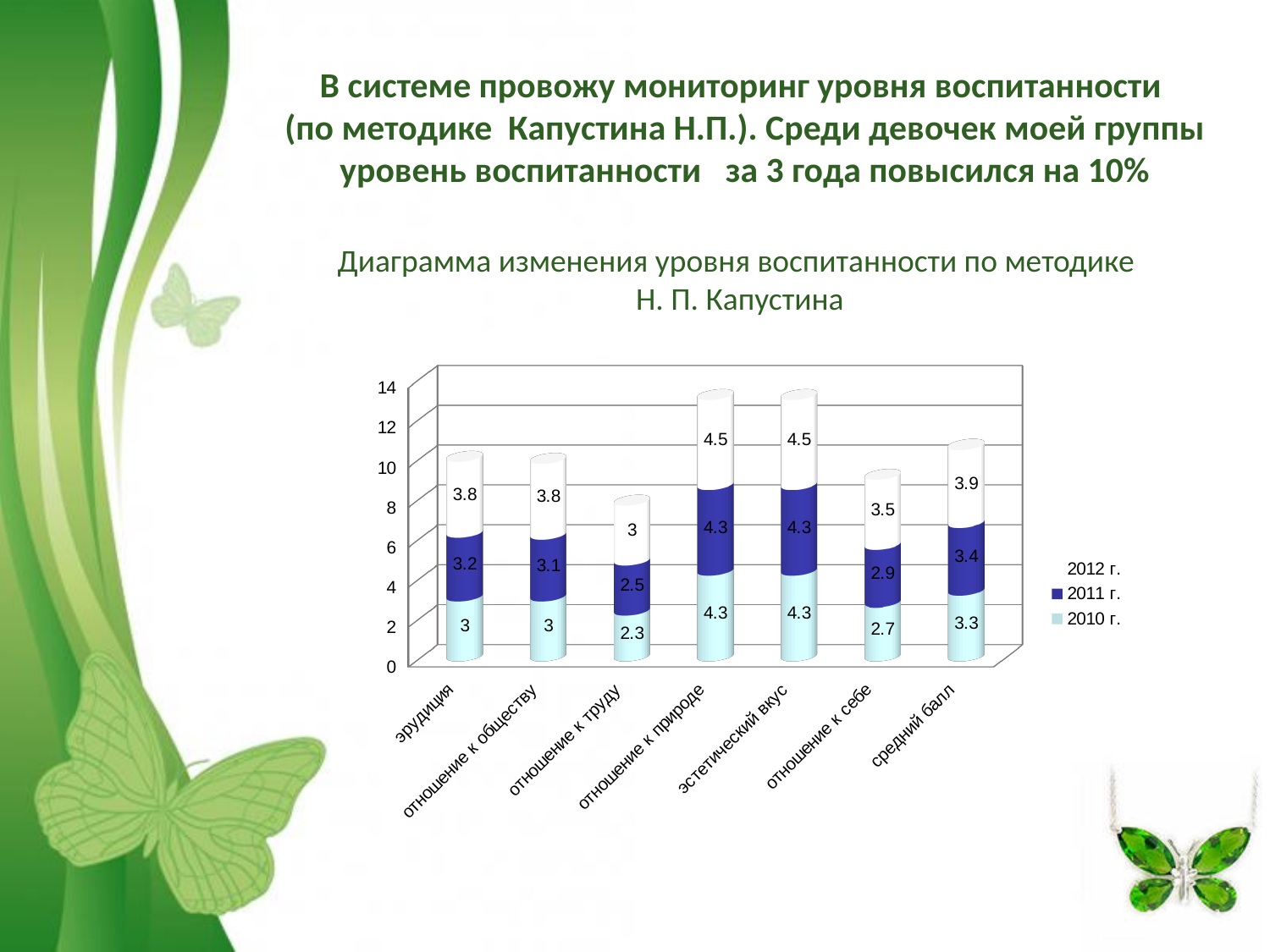
Which category has the lowest 2012 г. value? отношение к труду What is the 2011 г. value for отношение к себе? 2.9 How many series does the legend list? 3 Which is larger: the 2011 г. value for отношение к природе or the 2011 г. value for эрудиция? отношение к природе How many categories are shown on the x axis? 7 What is the difference between the 2012 г. and 2010 г. values for отношение к себе? 0.8 What is the 2010 г. value for отношение к труду? 2.3 What is the 2012 г. value for эрудиция? 3.8 What type of chart is shown on the slide? stacked bar chart Which series is shown in white in the legend? 2012 г. What is the total of the stacked bar for средний балл? 10.6 What is the 2012 г. value for средний балл? 3.9